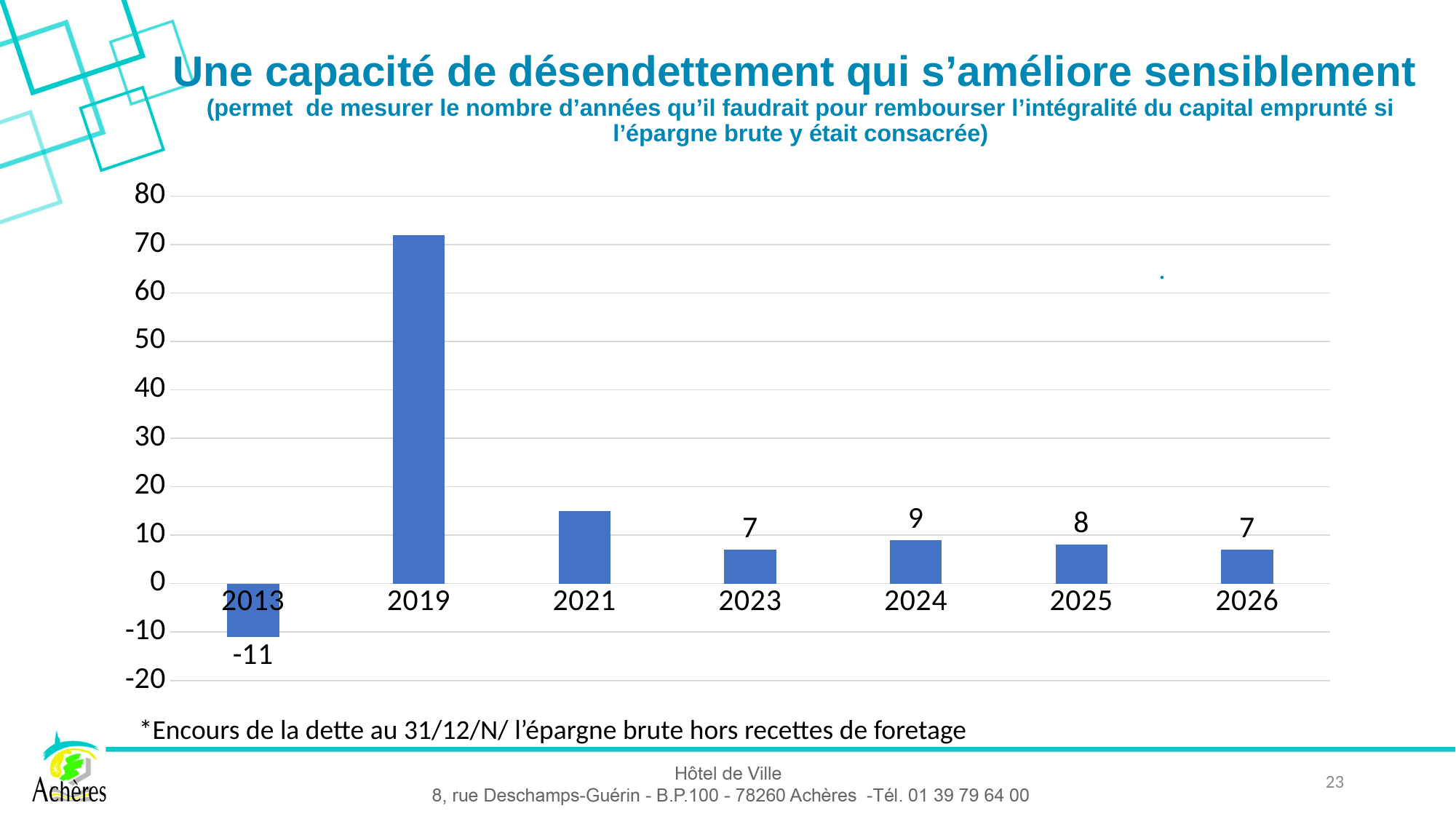
Which is larger, the value for 2023 or the value for 2024? 2024 What is the value for 2024? 9 What is the value for 2026? 7 What is the difference between the values for 2024 and 2025? 1 What kind of chart is shown on the slide? bar chart What is the value for 2013? -11 Which year has the lowest value? 2013 How many years are shown on the x axis? 7 Is the value for 2019 greater or less than 60? greater What is the value for 2025? 8 Is the value for 2021 greater or less than 10? greater Which year has the highest value? 2019